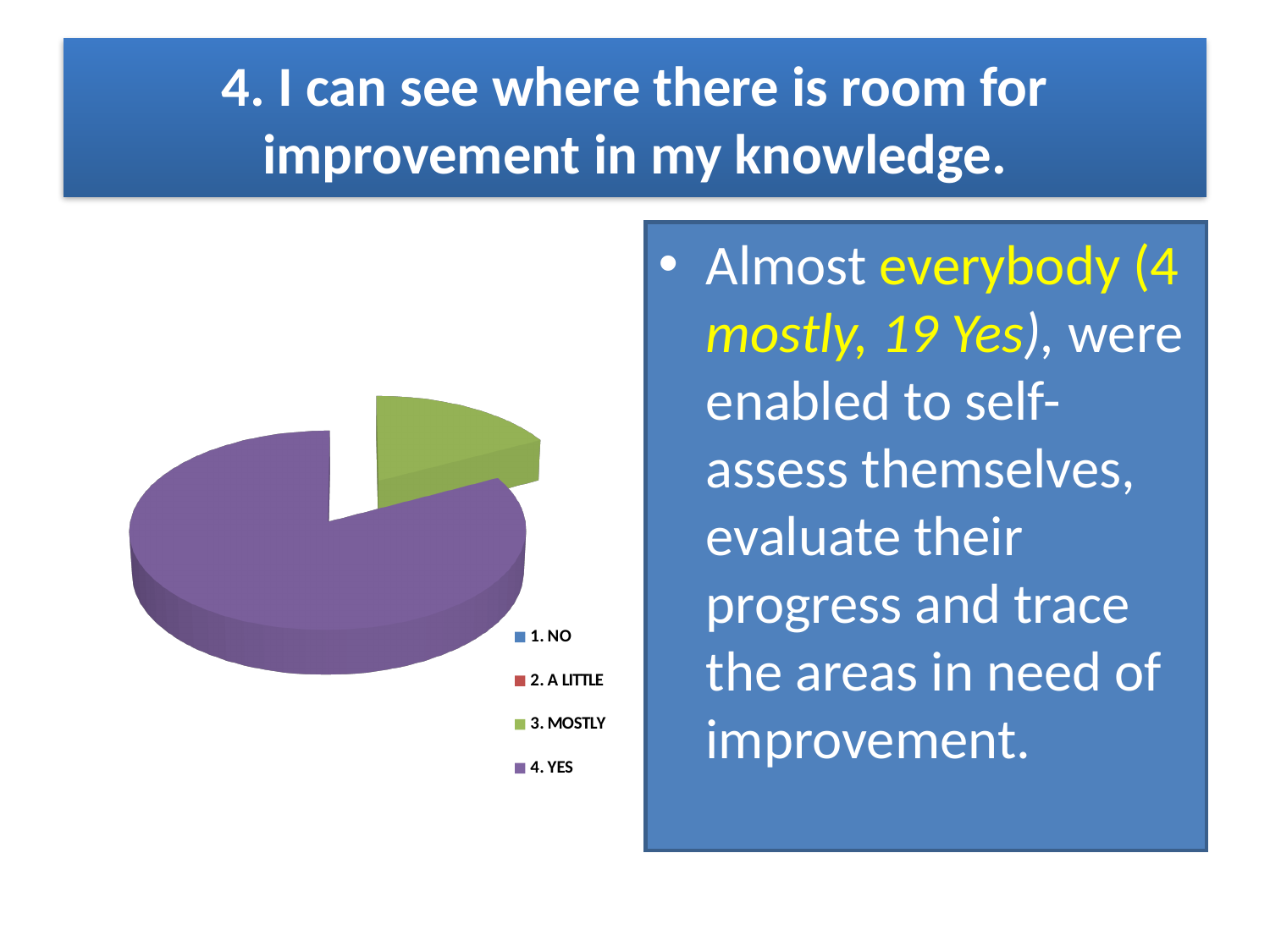
What kind of chart is shown on the slide? pie chart What colour is the slice for 4. YES? purple How many entries does the chart's legend list? 4 Which category has the largest slice of the pie? 4. YES Which slice is larger, 4. YES or 3. MOSTLY? 4. YES Which legend entry is listed first? 1. NO Does the 4. YES slice take up more or less than half of the pie? more How many slices are visibly drawn in the pie? 2 Which legend entry is shown in green? 3. MOSTLY